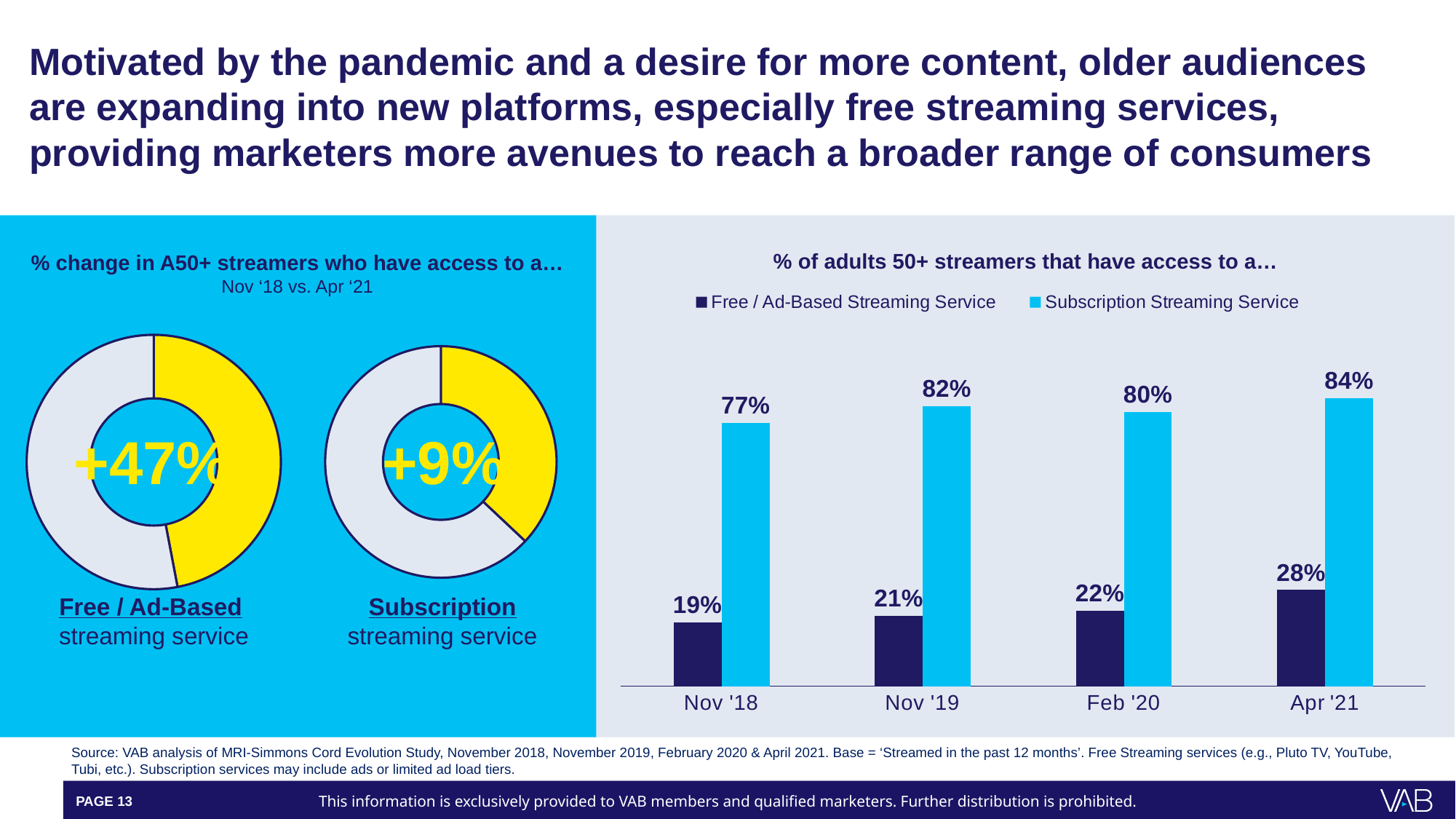
In the bar chart '% of adults 50+ streamers that have access to a…', what is the value for Free / Ad-Based Streaming Service in Apr '21? 28% In the bar chart '% of adults 50+ streamers that have access to a…', which is larger in Nov '19: Free / Ad-Based Streaming Service or Subscription Streaming Service? Subscription Streaming Service How many time periods are shown on the x axis of the bar chart '% of adults 50+ streamers that have access to a…'? 4 How many series does the legend of the bar chart '% of adults 50+ streamers that have access to a…' list? 2 In the bar chart '% of adults 50+ streamers that have access to a…', what is the value for Subscription Streaming Service in Nov '18? 77% What kind of chart is '% of adults 50+ streamers that have access to a…'? Bar chart In the bar chart '% of adults 50+ streamers that have access to a…', what is the difference between the Subscription Streaming Service values for Apr '21 and Nov '18? 7% In the donut charts on the left titled '% change in A50+ streamers who have access to a…', what is the % change shown for the Free / Ad-Based streaming service? +47% In the bar chart '% of adults 50+ streamers that have access to a…', which period has the lowest value for Free / Ad-Based Streaming Service? Nov '18 In the bar chart '% of adults 50+ streamers that have access to a…', which period has the highest value for Subscription Streaming Service? Apr '21 In the bar chart '% of adults 50+ streamers that have access to a…', do the Free / Ad-Based Streaming Service values rise or fall from Nov '18 to Apr '21? Rise In the bar chart '% of adults 50+ streamers that have access to a…', what is the value for Free / Ad-Based Streaming Service in Feb '20? 22%